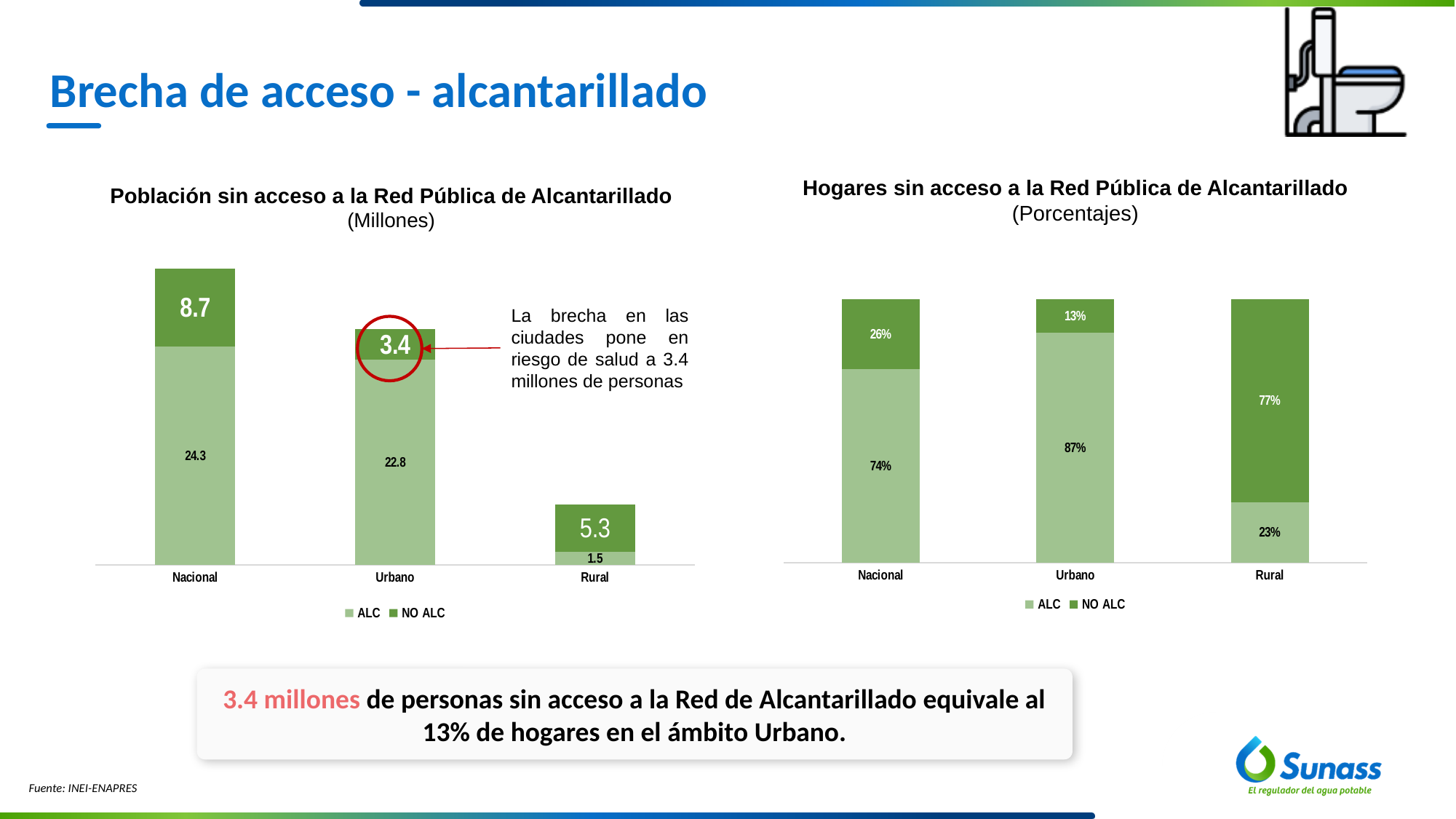
How many series does the legend of the chart 'Población sin acceso a la Red Pública de Alcantarillado (Millones)' list? 2 In the chart 'Población sin acceso a la Red Pública de Alcantarillado (Millones)', what is the difference between the NO ALC values for Nacional and Urbano? 5.3 How many categories are shown on the x axis of the chart 'Hogares sin acceso a la Red Pública de Alcantarillado (Porcentajes)'? 3 In the chart 'Población sin acceso a la Red Pública de Alcantarillado (Millones)', what is the NO ALC value for Urbano? 3.4 In the chart 'Población sin acceso a la Red Pública de Alcantarillado (Millones)', which category has the lowest ALC value? Rural In the chart 'Población sin acceso a la Red Pública de Alcantarillado (Millones)', which category has the highest NO ALC value? Nacional In the chart 'Hogares sin acceso a la Red Pública de Alcantarillado (Porcentajes)', what is the difference between the ALC values for Urbano and Rural? 64% In the chart 'Hogares sin acceso a la Red Pública de Alcantarillado (Porcentajes)', what is the NO ALC value for Rural? 77% In the chart 'Población sin acceso a la Red Pública de Alcantarillado (Millones)', what is the total of the stacked bar for Rural? 6.8 In the chart 'Hogares sin acceso a la Red Pública de Alcantarillado (Porcentajes)', which is larger, the NO ALC value for Nacional or for Urbano? Nacional In the chart 'Población sin acceso a la Red Pública de Alcantarillado (Millones)', what is the ALC value for Nacional? 24.3 In the chart 'Hogares sin acceso a la Red Pública de Alcantarillado (Porcentajes)', what is the ALC value for Urbano? 87%